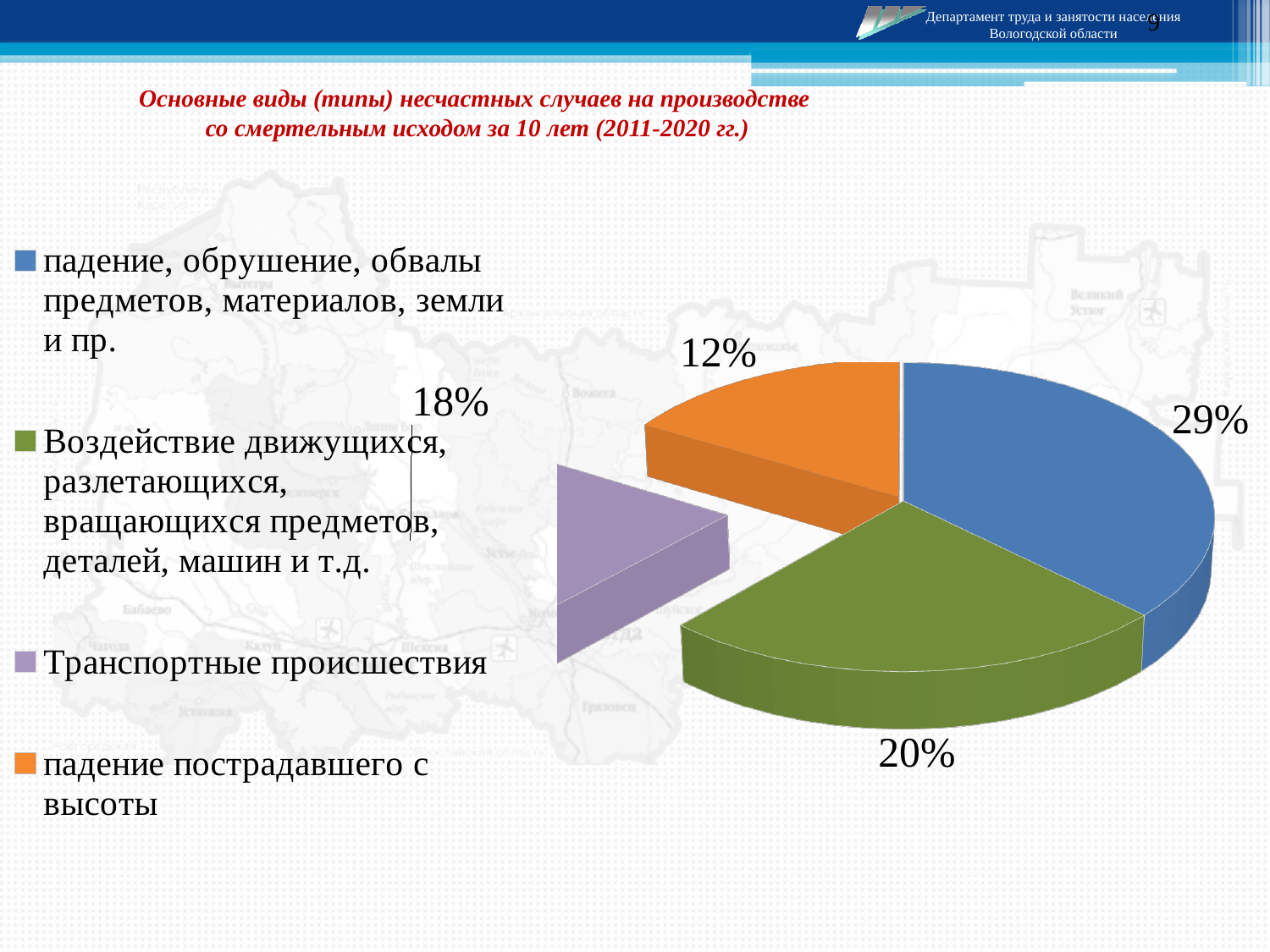
What percentage is shown for the slice "Воздействие движущихся, разлетающихся, вращающихся предметов, деталей, машин и т.д."? 20% Which category has the smallest slice of the pie? падение пострадавшего с высоты How many categories does the pie chart show? 4 Which category has the largest slice of the pie? падение, обрушение, обвалы предметов, материалов, земли и пр. What type of chart is shown on the slide? pie chart What colour is the slice labelled 29%? blue What percentage is shown for the slice "падение пострадавшего с высоты"? 12% What colour is the slice for "Транспортные происшествия"? purple What percentage is shown for the slice "Транспортные происшествия"? 18% What is the difference in percentage points between the largest slice (29%) and the smallest slice (12%)? 17 What percentage is shown for the slice "падение, обрушение, обвалы предметов, материалов, земли и пр."? 29% Which is larger: the share for "Транспортные происшествия" or the share for "падение пострадавшего с высоты"? Транспортные происшествия